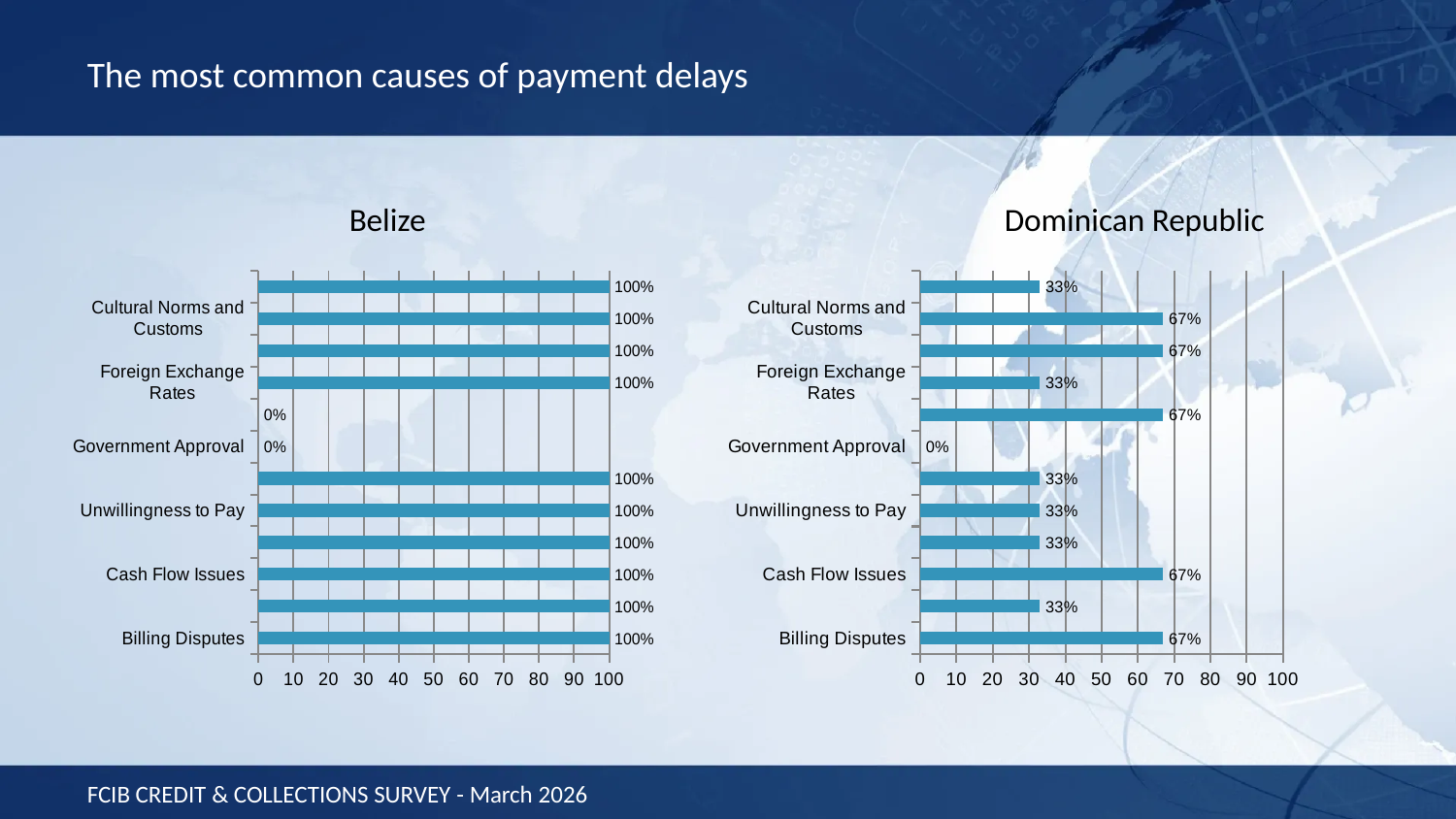
What is the title of the chart on the right side of the slide? Dominican Republic In the Belize chart, what is the difference between Unwillingness to Pay and Government Approval? 100 percentage points How many category labels are shown on the Dominican Republic chart's vertical axis? 6 In the Belize chart, which is larger: Billing Disputes or Government Approval? Billing Disputes In the Belize chart, which labeled category has the lowest value? Government Approval In the Dominican Republic chart, what is the value for Government Approval? 0% In the Dominican Republic chart, what is the highest value shown on any bar? 67% In the Belize chart, what is the value for Billing Disputes? 100% In the Dominican Republic chart, what is the value for Unwillingness to Pay? 33% In the Belize chart, what is the value for Government Approval? 0% What type of chart is used for Belize? bar chart In the Belize chart, what is the value for Cash Flow Issues? 100%